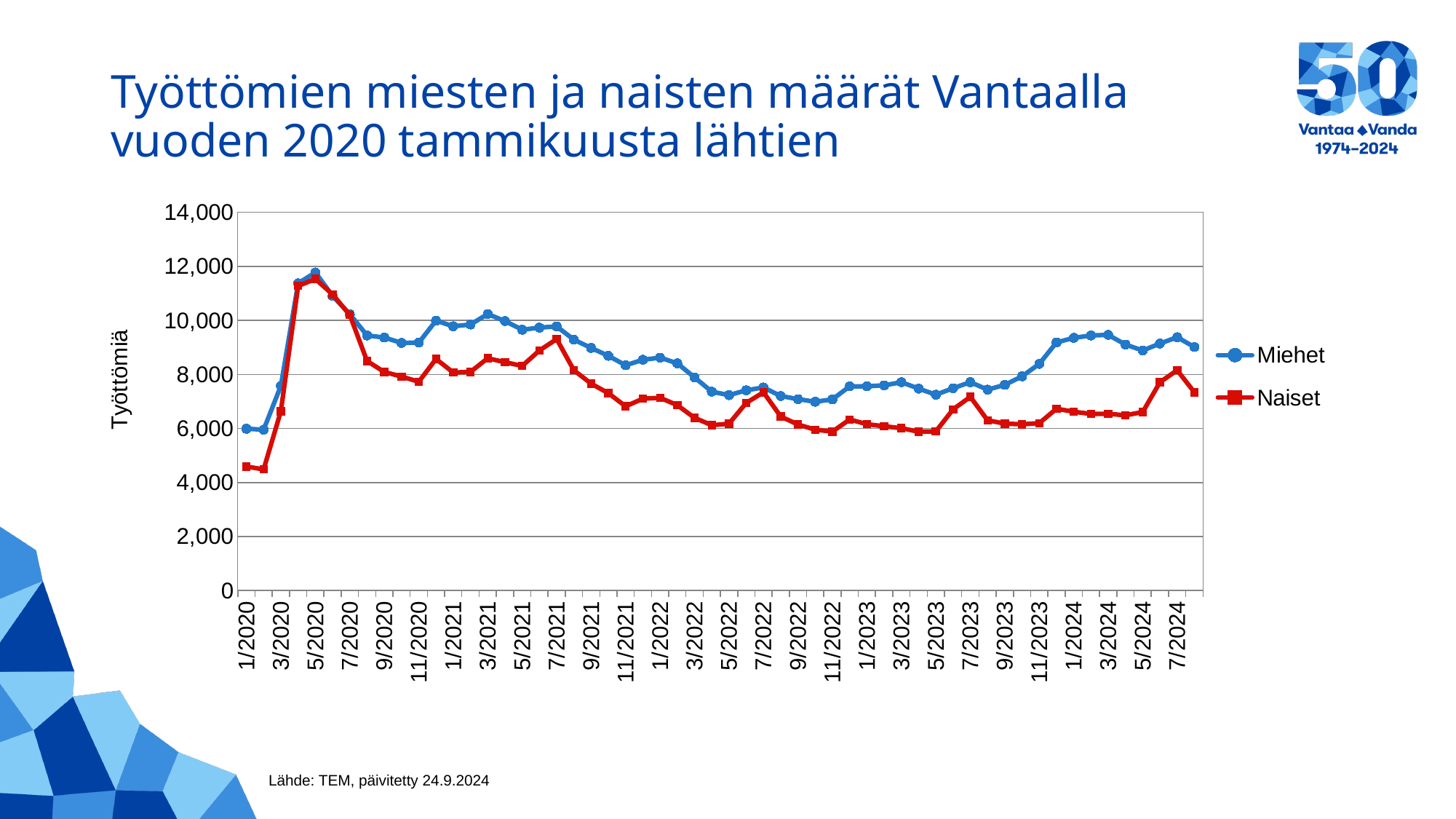
Do the values for Miehet rise or fall between 1/2020 and 5/2020? Rise In 1/2020, which series has the larger value, Miehet or Naiset? Miehet Is the value for Naiset in 5/2020 greater or less than 10,000? greater Is the value for Naiset in 1/2020 greater or less than 6,000? less In which month does the Miehet series reach its highest value? 5/2020 What is the label on the vertical axis? Työttömiä What kind of chart is shown on the slide? Line chart Is the value for Miehet in 5/2020 greater or less than 10,000? greater What are the two series named in the legend? Miehet and Naiset How many series does the legend list? 2